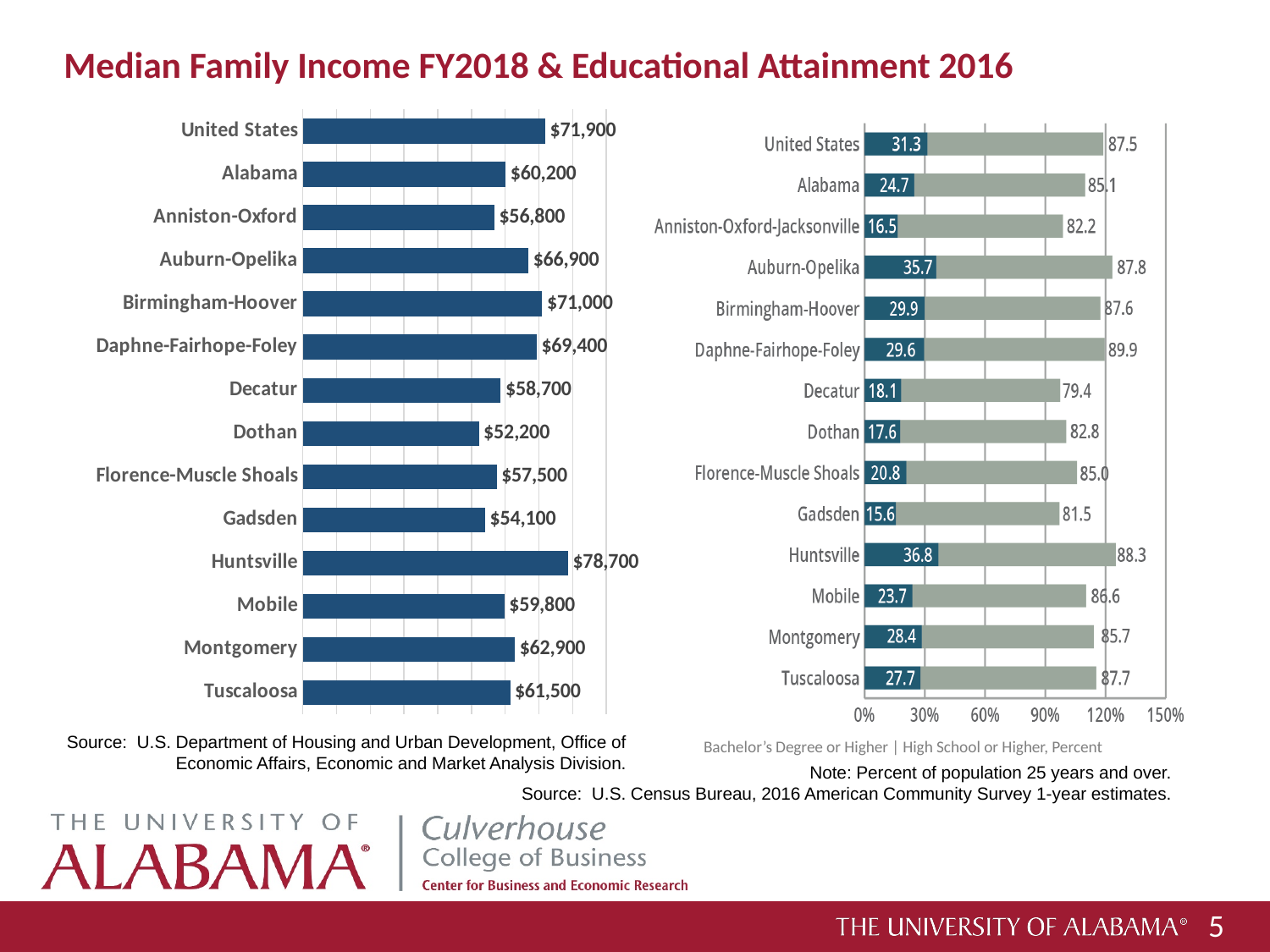
In the Educational Attainment chart on the right, which area has the highest percent with a bachelor's degree or higher? Huntsville In the Educational Attainment chart on the right, which area has the lowest percent with a high school diploma or higher? Decatur In the Educational Attainment chart on the right, what percent of Auburn-Opelika's population has a bachelor's degree or higher? 35.7 In the Median Family Income chart on the left, which area has the lowest median family income? Dothan In the Median Family Income chart on the left, how many areas are listed? 14 In the Median Family Income chart on the left, how much higher is Huntsville's median family income than the United States figure? $6,800 In the Educational Attainment chart on the right, how many series does the legend list? 2 What kind of chart is the Median Family Income chart on the left? Bar chart In the Median Family Income chart on the left, which has the larger median family income, Montgomery or Tuscaloosa? Montgomery In the Median Family Income chart on the left, which area has the highest median family income? Huntsville In the Median Family Income chart on the left, what is the median family income for Huntsville? $78,700 In the Educational Attainment chart on the right, what is the total of the two stacked segments for the United States bar? 118.8